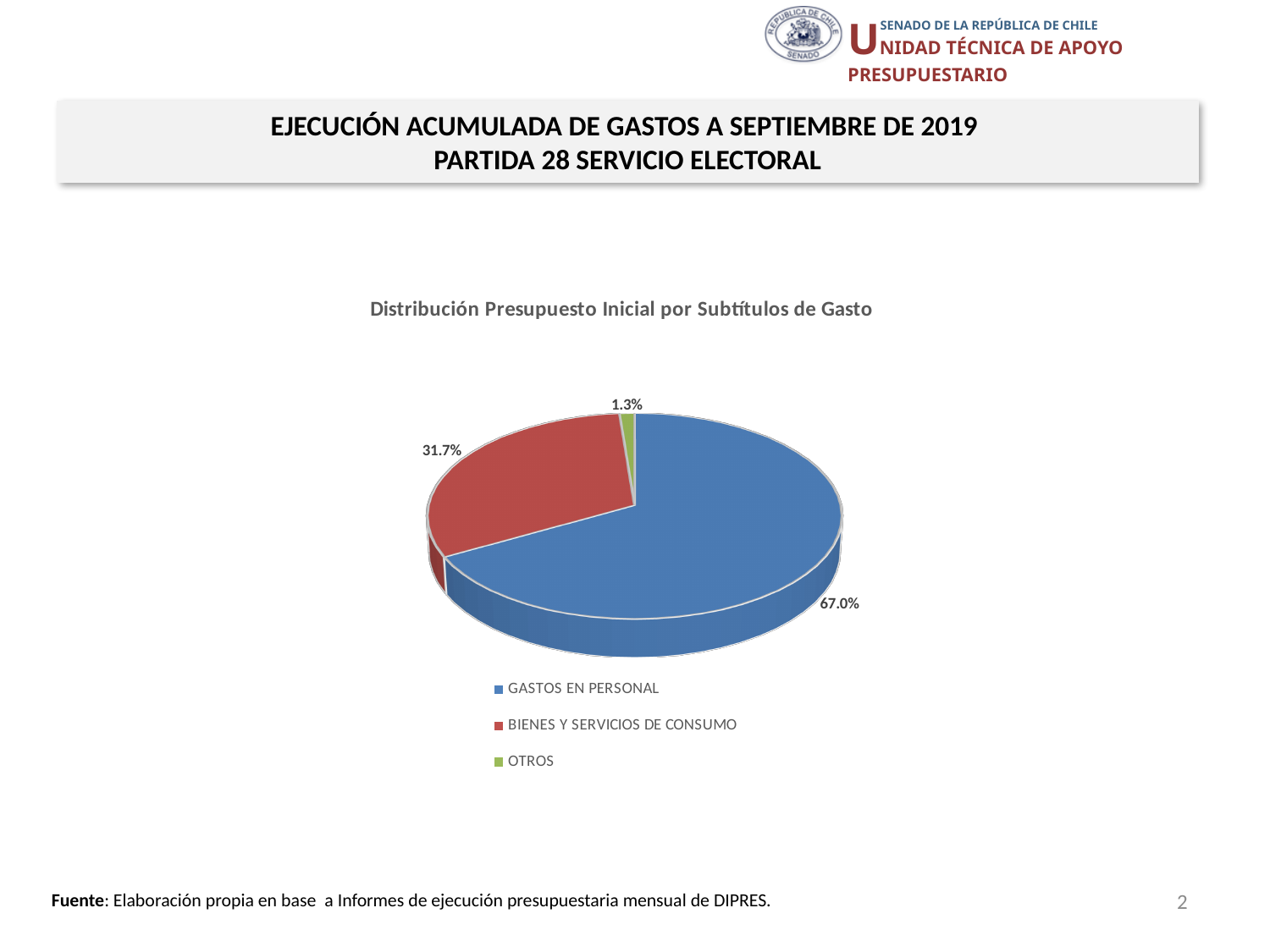
How many entries does the legend list? 3 What share of the pie does BIENES Y SERVICIOS DE CONSUMO represent? 31.7% Which is larger, the share for BIENES Y SERVICIOS DE CONSUMO or the share for OTROS? BIENES Y SERVICIOS DE CONSUMO What kind of chart is shown on the slide? Pie chart What colour is the slice for BIENES Y SERVICIOS DE CONSUMO? Red What is the title of the chart? Distribución Presupuesto Inicial por Subtítulos de Gasto What share of the pie does OTROS represent? 1.3% Which category has the smallest share of the pie? OTROS Which category has the largest share of the pie? GASTOS EN PERSONAL What is the difference in percentage points between GASTOS EN PERSONAL and BIENES Y SERVICIOS DE CONSUMO? 35.3 What share of the pie does GASTOS EN PERSONAL represent? 67.0% How many categories does the pie chart have? 3